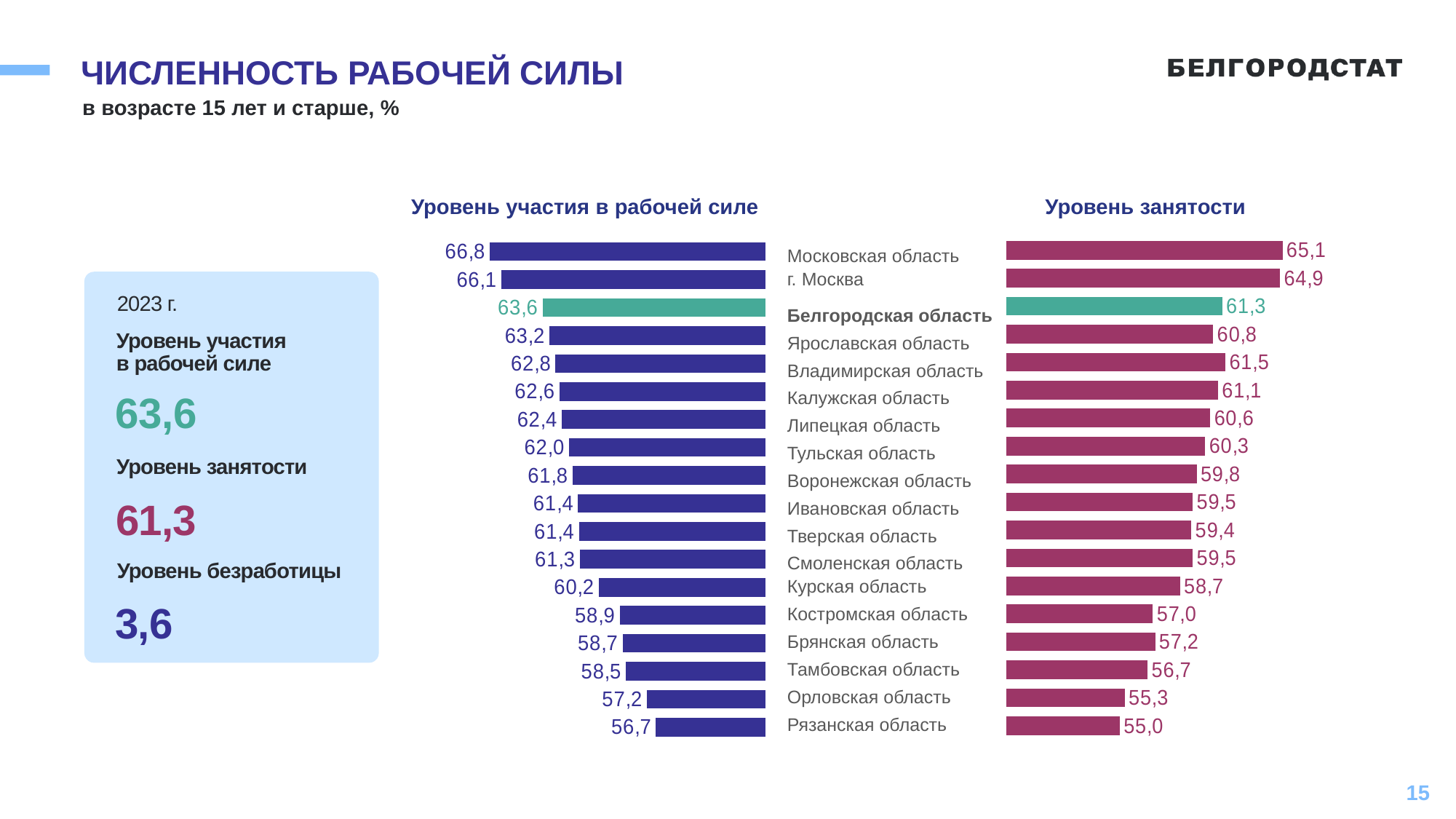
In the chart "Уровень участия в рабочей силе", what is the difference between the values for Московская область and Рязанская область? 10,1 In the chart "Уровень занятости", which region has the lowest value? Рязанская область In the chart "Уровень участия в рабочей силе", which region has the highest value? Московская область In the chart "Уровень занятости", what is the value for Владимирская область? 61,5 In the chart "Уровень занятости", what is the difference between the values for Белгородская область and Ярославская область? 0,5 In the chart "Уровень участия в рабочей силе", which is larger: the value for Курская область or Костромская область? Курская область In the chart "Уровень участия в рабочей силе", what is the value for Белгородская область? 63,6 In the chart "Уровень участия в рабочей силе", which region's bar is highlighted in a different colour (green) from the others? Белгородская область In the chart "Уровень занятости", what is the value for г. Москва? 64,9 What kind of chart is "Уровень участия в рабочей силе"? Bar chart In the chart "Уровень занятости", which is larger: the value for Брянская область or Костромская область? Брянская область How many regions are shown in the chart "Уровень занятости"? 18